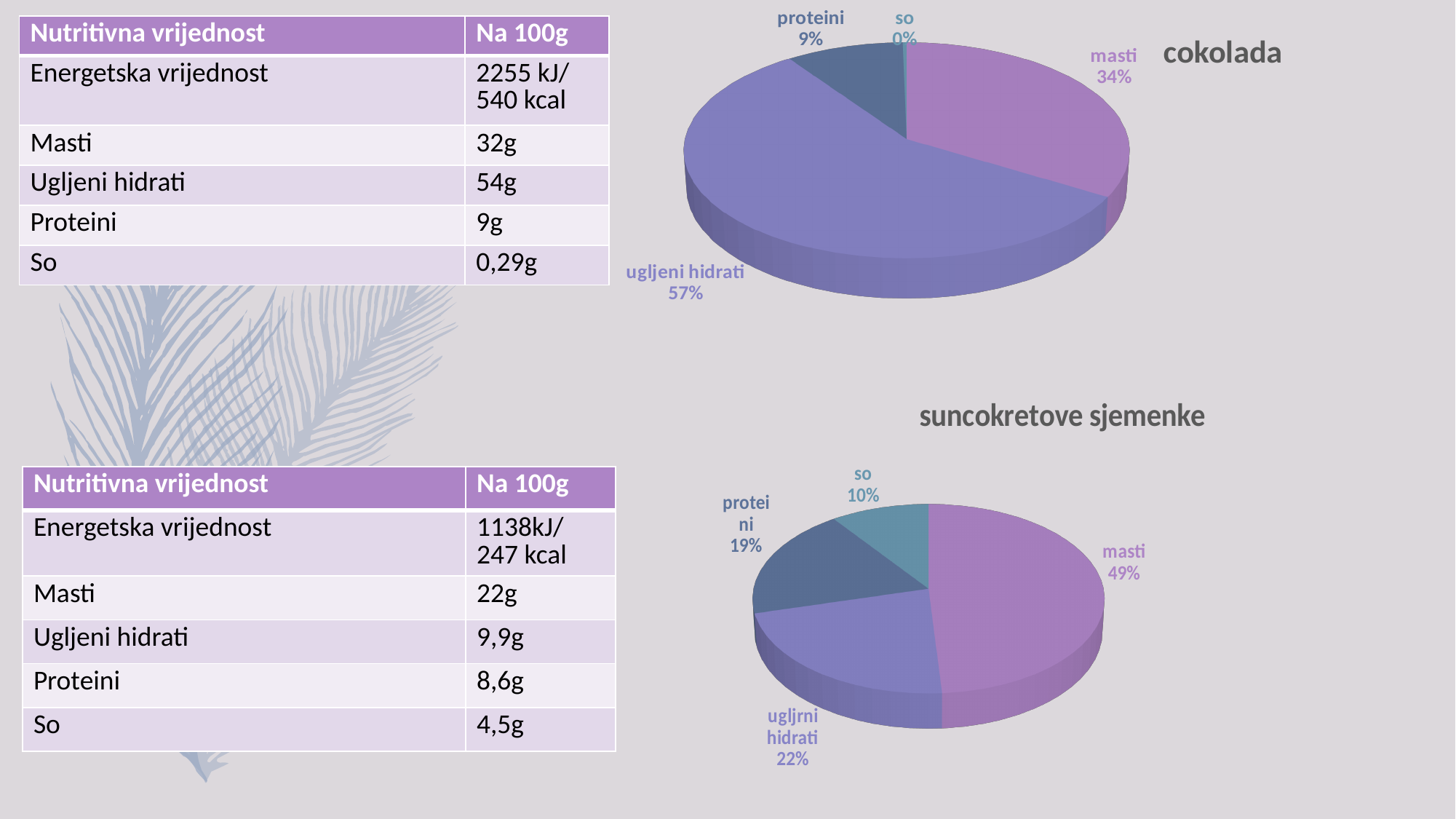
In the 'cokolada' pie chart, what share does 'masti' have? 34% In the 'cokolada' pie chart, which slice is the smallest? so In the 'cokolada' pie chart, how many slices are labelled? 4 In the 'cokolada' pie chart, which slice is the largest? ugljeni hidrati In the 'suncokretove sjemenke' pie chart, which slice is the largest? masti In the 'cokolada' pie chart, what share does 'proteini' have? 9% In the 'suncokretove sjemenke' pie chart, which is larger, the 'ugljrni hidrati' slice or the 'proteini' slice? ugljrni hidrati In the 'suncokretove sjemenke' pie chart, what share does 'so' have? 10% What type of chart is used for 'cokolada'? pie chart In the 'suncokretove sjemenke' pie chart, what is the difference between the 'masti' share and the 'proteini' share? 30%